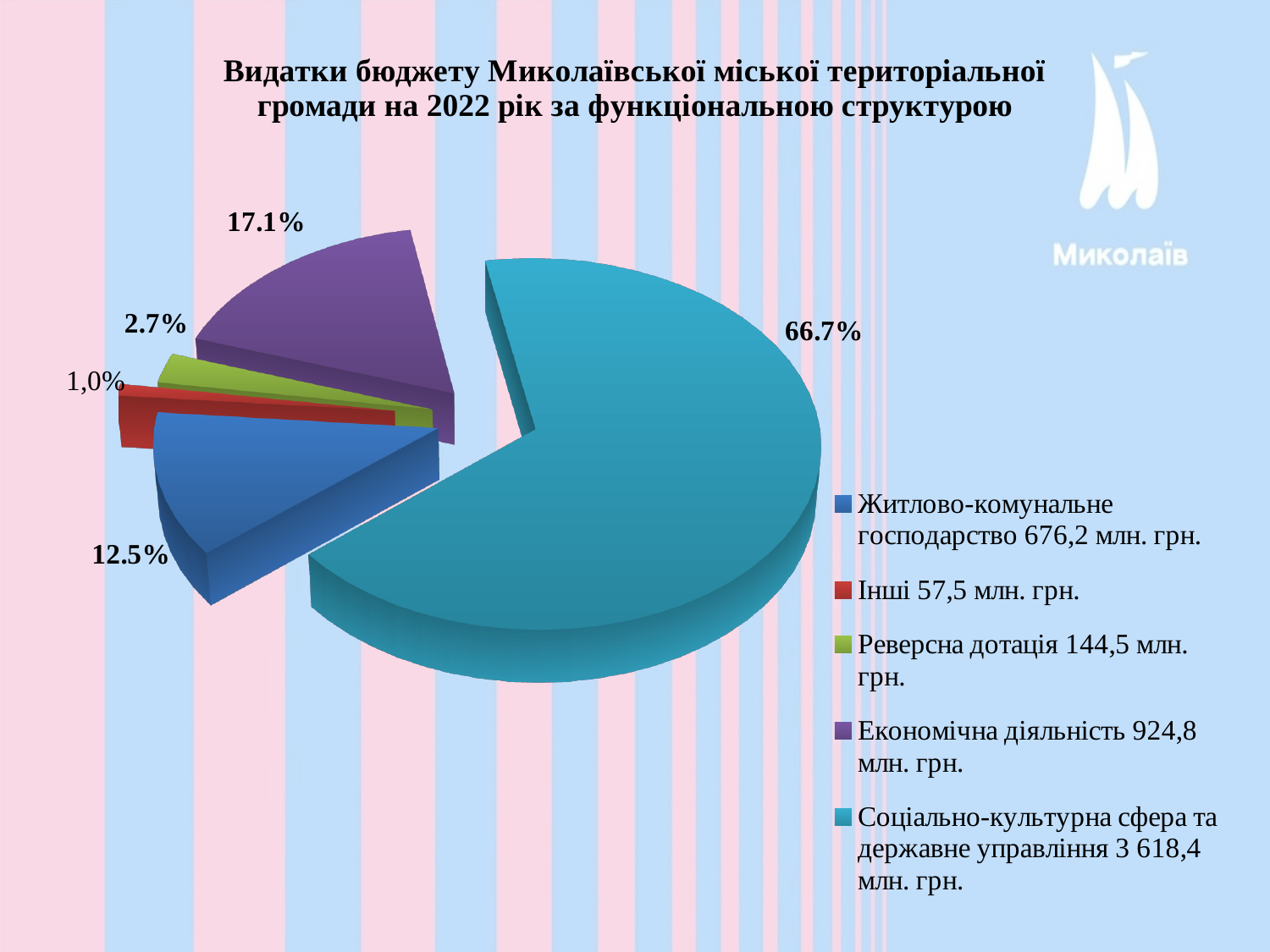
How many entries does the legend list? 5 According to the legend, what is the amount for "Економічна діяльність"? 924,8 млн. грн. How many slices does the pie chart have? 5 What kind of chart is shown on the slide? Pie chart Which category has the largest slice of the pie? Соціально-культурна сфера та державне управління Which is larger: the share for "Житлово-комунальне господарство" or the share for "Економічна діяльність"? Економічна діяльність What share of the pie does "Житлово-комунальне господарство" take? 12.5% Which category has the smallest slice of the pie? Інші What share of the pie does "Економічна діяльність" take? 17.1% What share of the pie does "Реверсна дотація" take? 2.7% What is the difference in percentage points between the "Економічна діяльність" slice and the "Житлово-комунальне господарство" slice? 4.6